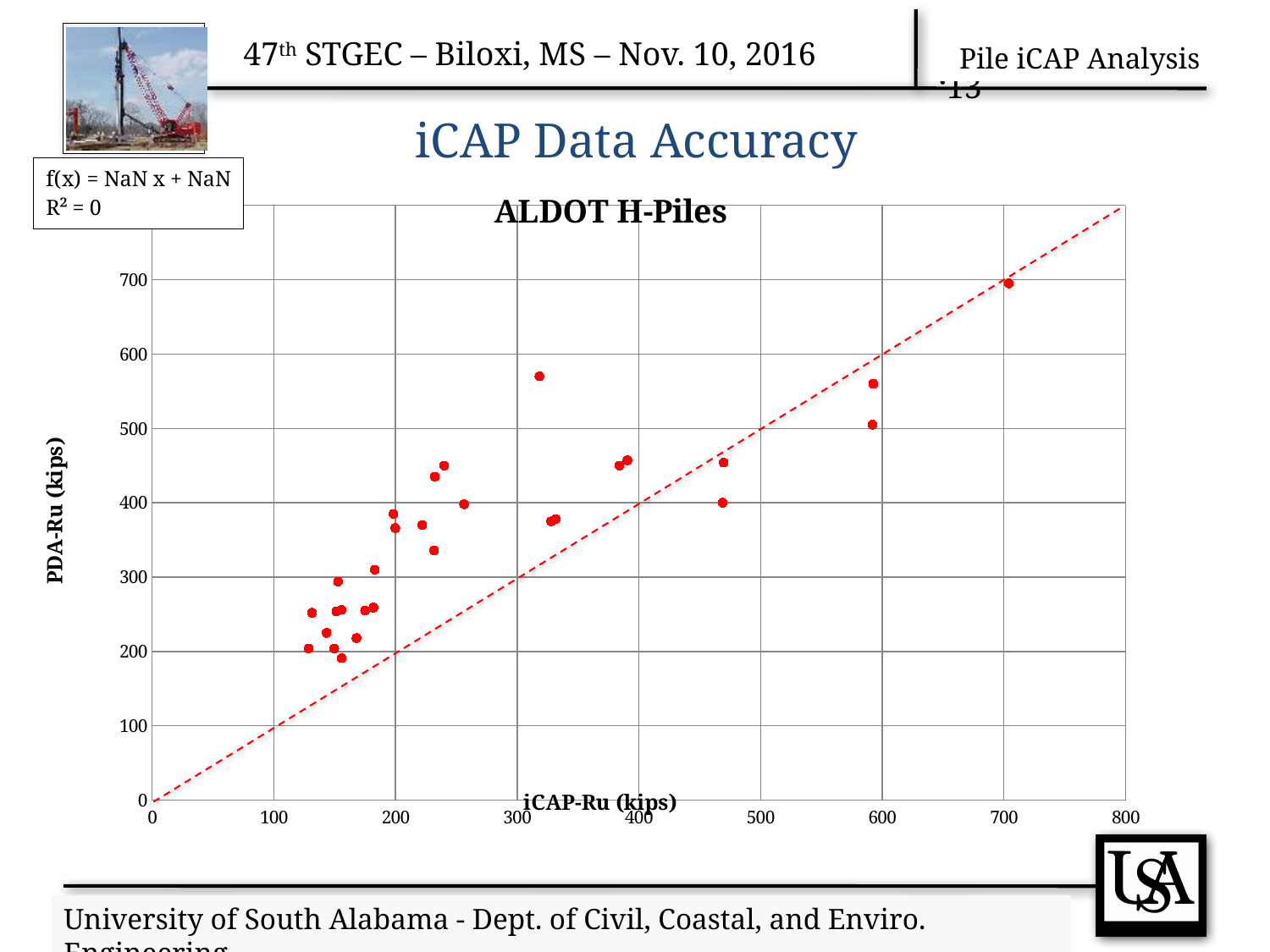
Do the PDA-Ru values generally rise or fall as iCAP-Ru increases along the x axis? rise Is the iCAP-Ru value of the lowest point on the chart greater or less than 300? less Is the PDA-Ru value of the point near iCAP-Ru 320 that lies well above the dashed line greater or less than 500? greater Is the PDA-Ru value of the lowest point on the chart greater or less than 300? less What is the label on the vertical axis of the chart? PDA-Ru (kips) How many points have an iCAP-Ru value greater than 600? 1 What is the title of the chart? ALDOT H-Piles What kind of chart is shown on the slide? scatter chart